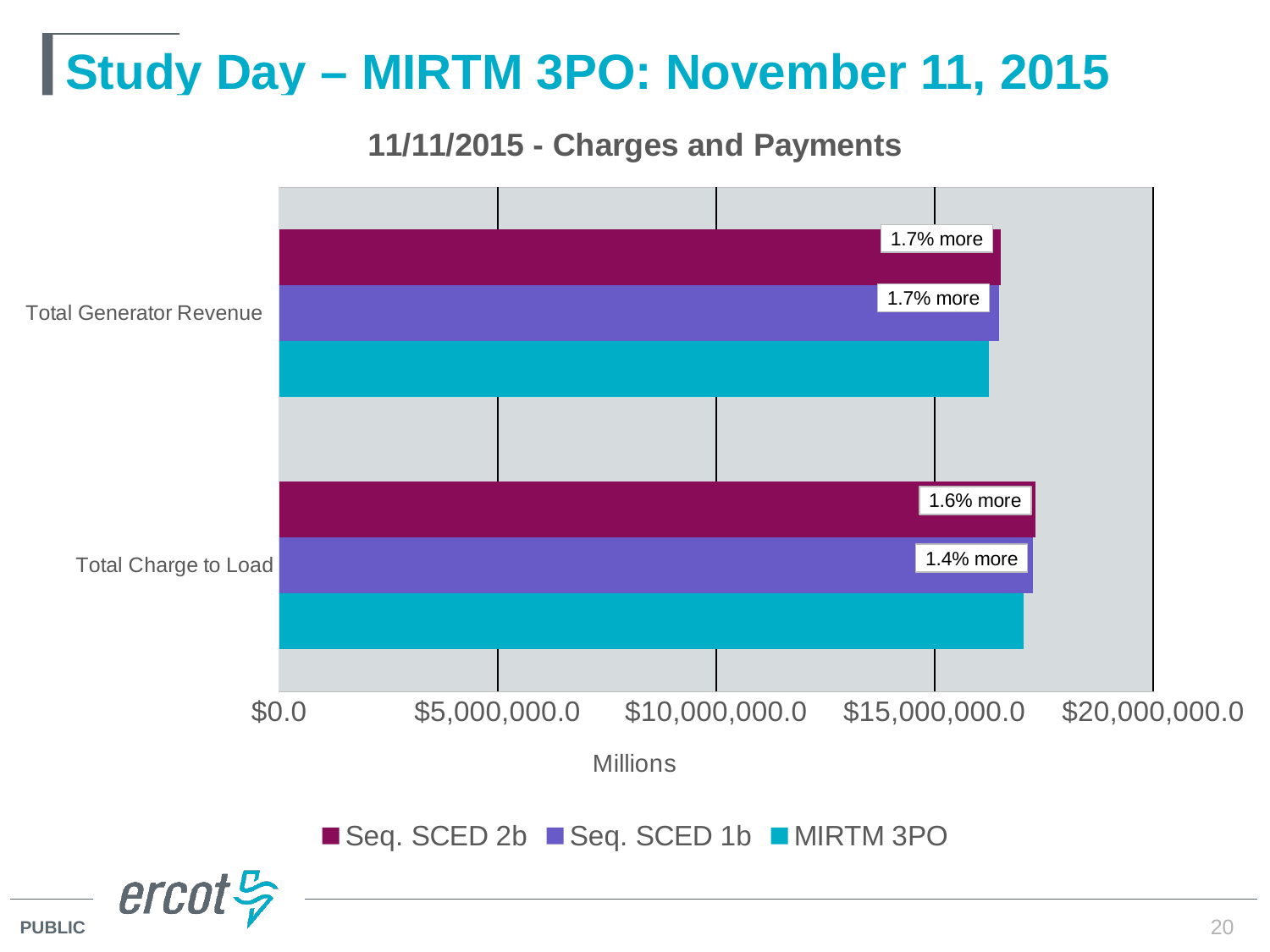
What data label is shown on the Seq. SCED 1b bar for Total Charge to Load? 1.4% more What kind of chart is shown on the slide? bar chart How many categories are shown on the vertical axis? 2 What data label is shown on the Seq. SCED 2b bar for Total Generator Revenue? 1.7% more For Total Charge to Load, which is larger: the Seq. SCED 2b bar or the MIRTM 3PO bar? Seq. SCED 2b What is the title of the chart? 11/11/2015 - Charges and Payments What data label is shown on the Seq. SCED 2b bar for Total Charge to Load? 1.6% more Is the Seq. SCED 2b value for Total Charge to Load greater or less than $20,000,000.0? less Which series is shown in the teal/cyan colour in the legend? MIRTM 3PO For the MIRTM 3PO series, which category has the larger value: Total Generator Revenue or Total Charge to Load? Total Charge to Load How many series does the legend list? 3 Is the MIRTM 3PO value for Total Generator Revenue greater or less than $15,000,000.0? greater